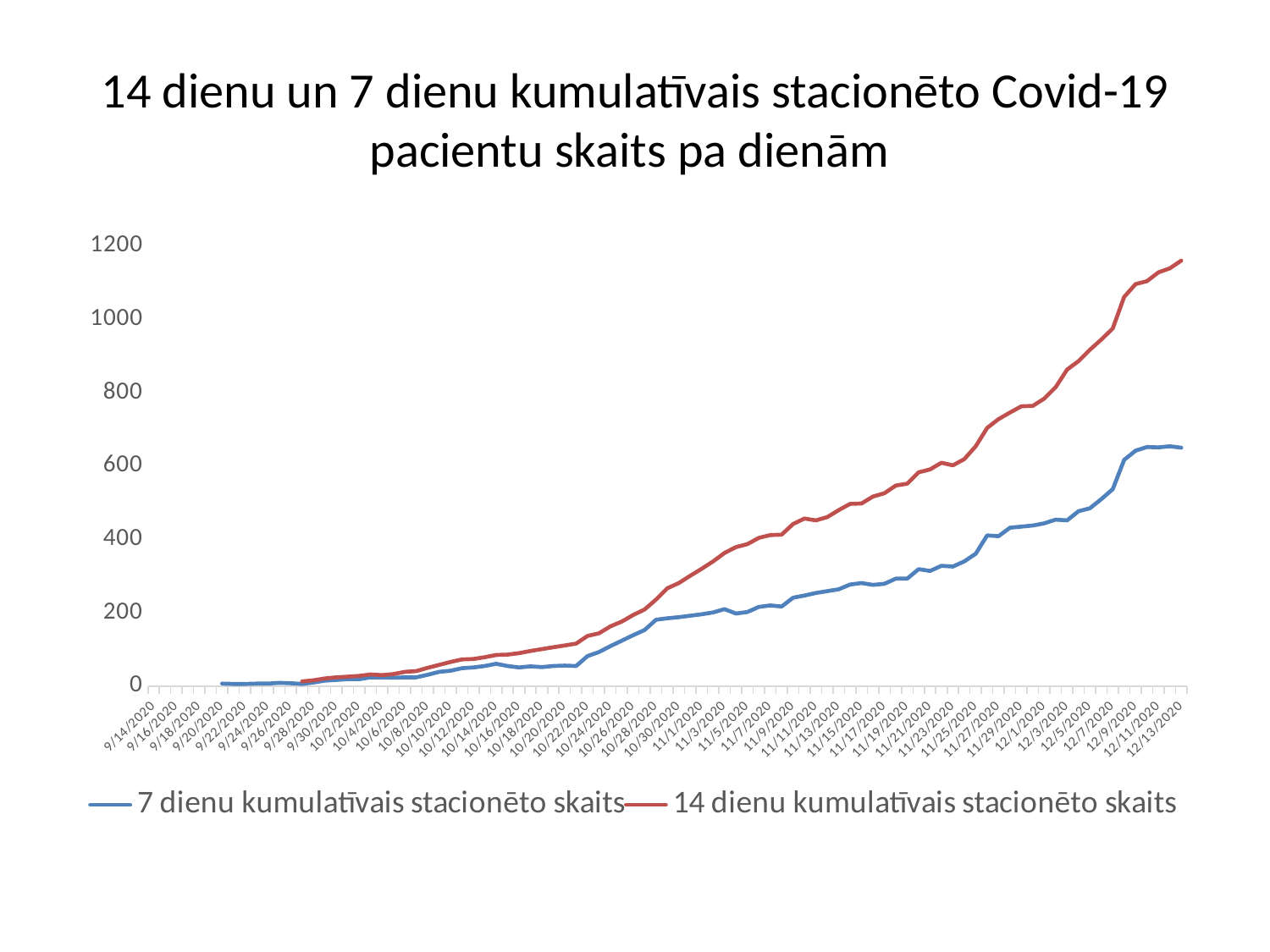
Is the value of '14 dienu kumulatīvais stacionēto skaits' on 12/13/2020 greater or less than 1000? greater Which series has the higher value on 12/13/2020, '7 dienu kumulatīvais stacionēto skaits' or '14 dienu kumulatīvais stacionēto skaits'? 14 dienu kumulatīvais stacionēto skaits Is the value of '7 dienu kumulatīvais stacionēto skaits' on 10/14/2020 greater or less than 200? less Is the value of '7 dienu kumulatīvais stacionēto skaits' on 12/13/2020 greater or less than 600? greater Which series reaches the highest value on the chart? 14 dienu kumulatīvais stacionēto skaits What colour is the line for '7 dienu kumulatīvais stacionēto skaits'? blue Do the values of the '14 dienu kumulatīvais stacionēto skaits' series rise or fall from 9/14/2020 to 12/13/2020? rise Do the values of the '7 dienu kumulatīvais stacionēto skaits' series generally rise or fall along the x axis? rise What kind of chart is shown on the slide? line chart How many series does the legend list? 2